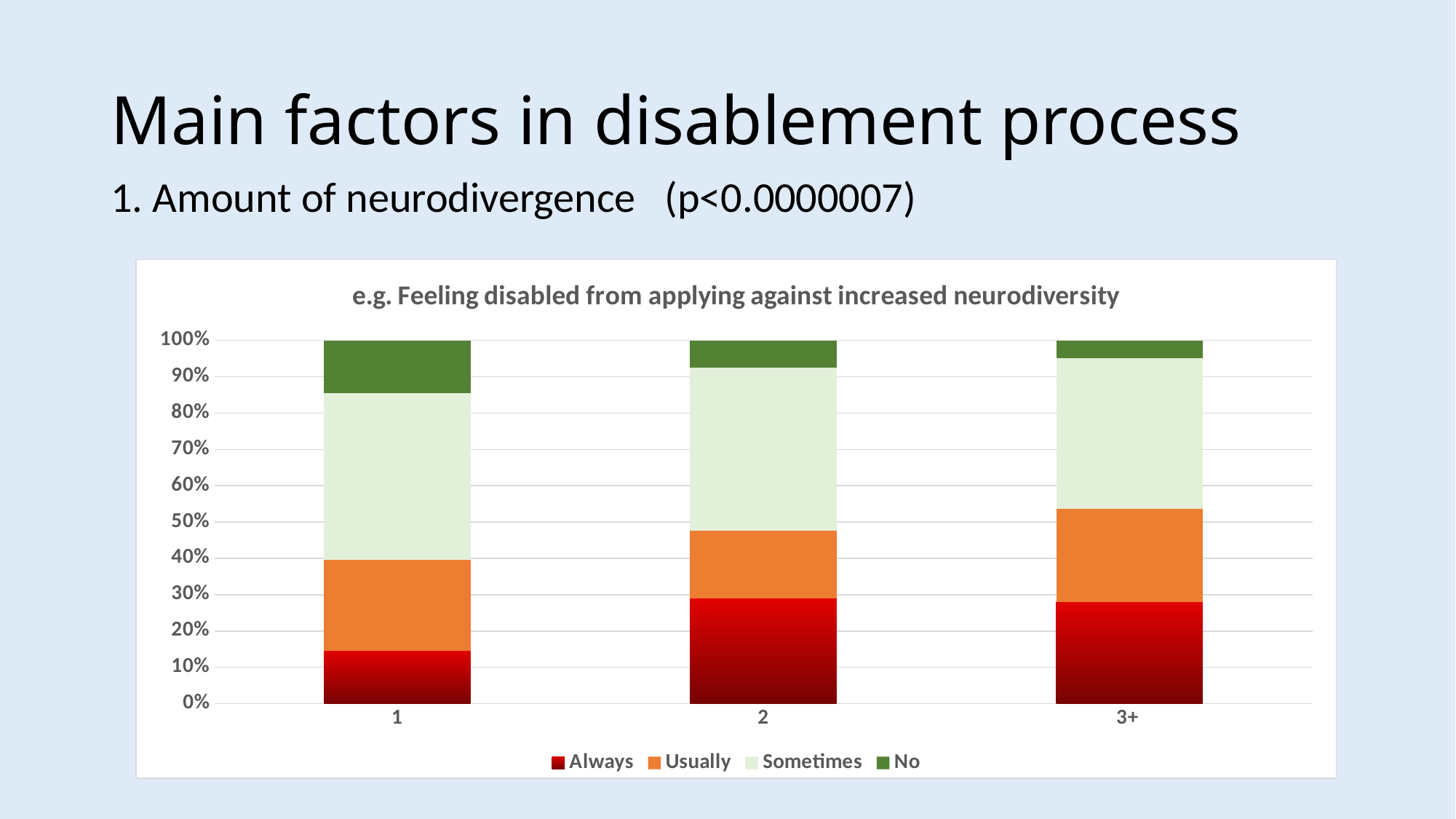
Which category has the smallest 'Always' segment? 1 Is the 'Always' segment for category 1 larger or smaller than the 'Always' segment for category 2? smaller Which category has the smallest 'Usually' segment? 2 What is the title of the chart? e.g. Feeling disabled from applying against increased neurodiversity What is the total of the stacked bar for category 3+? 100% Which series is shown in dark green in the chart? No Is the 'Always' value for category 2 greater or less than 20%? greater Is the 'Always' value for category 1 greater or less than 20%? less Which category has the largest 'No' segment? 1 How many categories are shown on the x axis of the chart? 3 What kind of chart is shown on the slide? Stacked bar chart How many series does the chart's legend list? 4